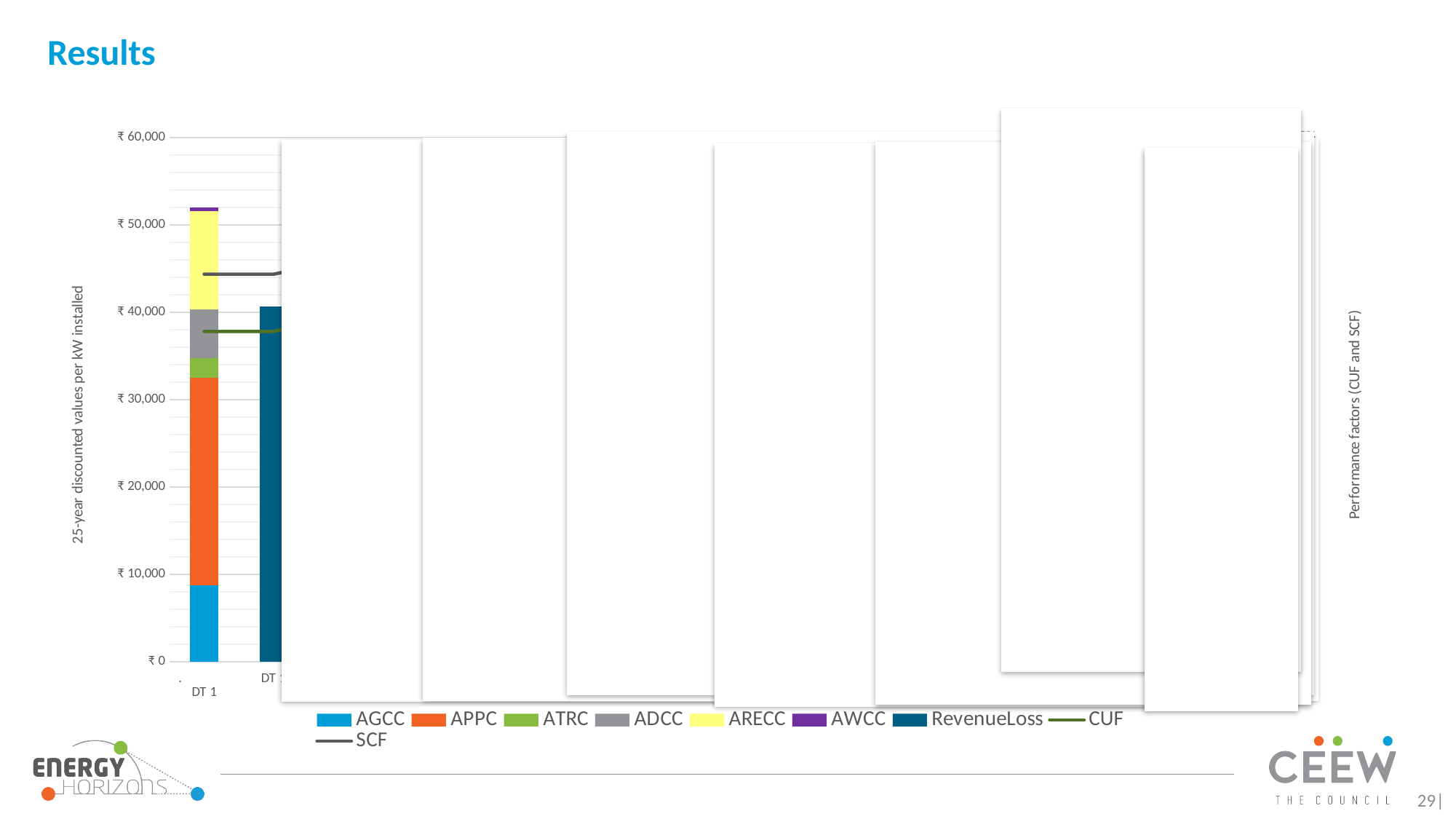
Is the top of the stacked bar for DT 1 greater or less than ₹60,000? less What is the title of the left vertical axis? 25-year discounted values per kW installed Is the top of the stacked bar for DT 1 greater or less than ₹50,000? greater Is the AGCC segment for DT 1 greater or less than ₹10,000? less Which cost component forms the largest segment of the DT 1 stacked bar? APPC How many series does the chart legend list? 9 Which is larger in the DT 1 stacked bar, the APPC segment or the ATRC segment? APPC Which cost component forms the smallest segment of the DT 1 stacked bar? AWCC What kind of chart is shown on the slide? combination bar and line chart What is the title of the right vertical axis? Performance factors (CUF and SCF)